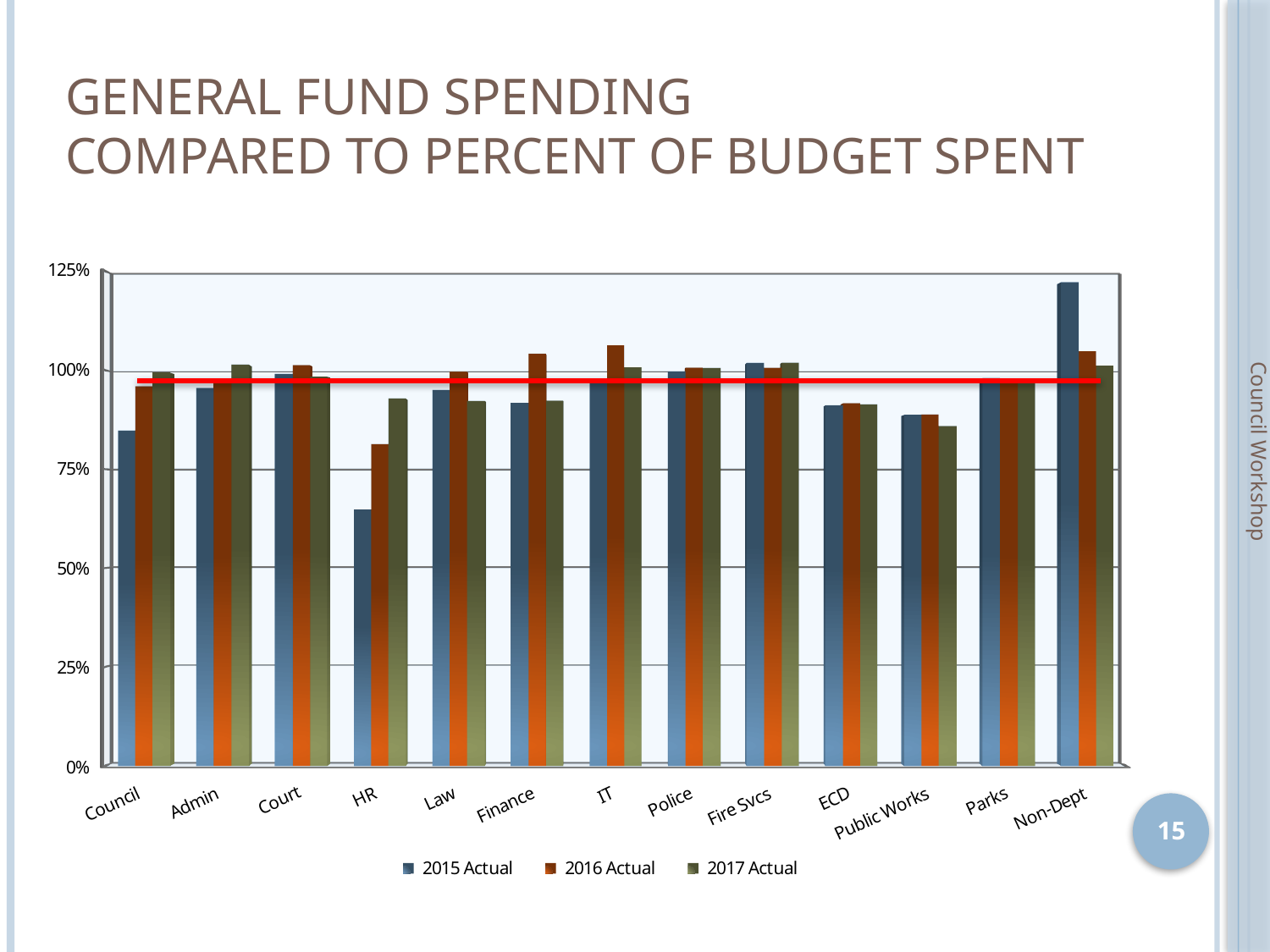
What is the title of the chart on the slide? General Fund Spending Compared to Percent of Budget Spent Is the 2017 Actual value for Public Works greater or less than 100%? less Is the 2016 Actual value for IT greater or less than 100%? greater What kind of chart is shown on the slide? bar chart Which department has the highest 2015 Actual value? Non-Dept Which department has the lowest 2016 Actual value? HR Is the 2015 Actual value for Non-Dept greater or less than 100%? greater How many series does the legend list? 3 How many departments (categories) are shown on the x axis? 13 Which is larger, the 2015 Actual value for Council or the 2015 Actual value for HR? Council Which department has the lowest 2015 Actual value? HR